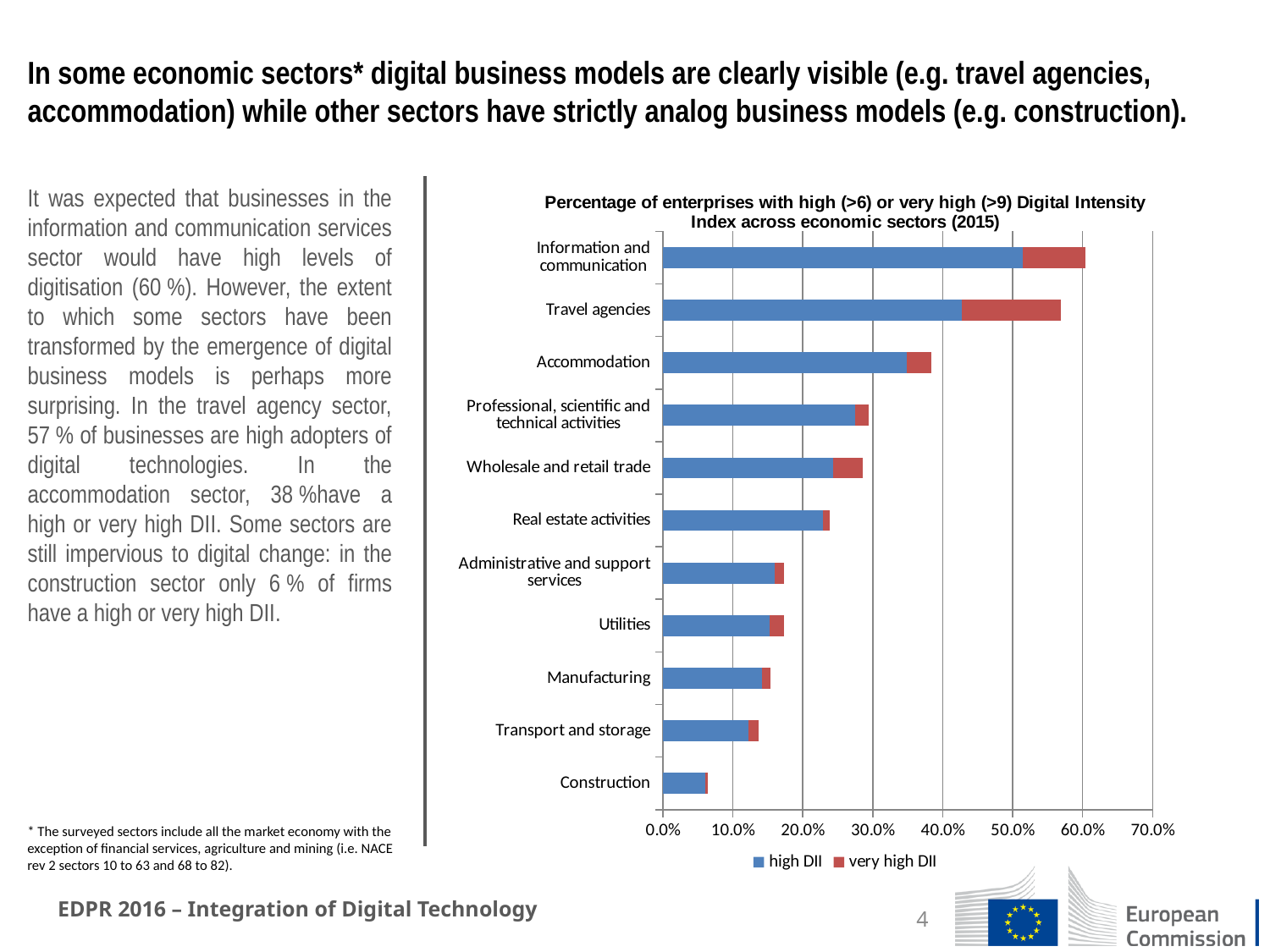
Is the total bar for Information and communication greater or less than 50.0%? greater How many series does the chart legend list? 2 How many economic sectors are plotted in the chart? 11 Which sector has the lowest total percentage of enterprises with high or very high DII? Construction Is the total bar for Accommodation greater or less than 30.0%? greater Is the total bar for Construction greater or less than 10.0%? less Which sector has the highest total percentage of enterprises with high or very high DII? Information and communication Which sector has the larger 'very high DII' segment, Travel agencies or Information and communication? Travel agencies Which colour represents the 'very high DII' series in the chart? Red What kind of chart is shown on the slide? Stacked bar chart Which has a larger total bar, Travel agencies or Accommodation? Travel agencies